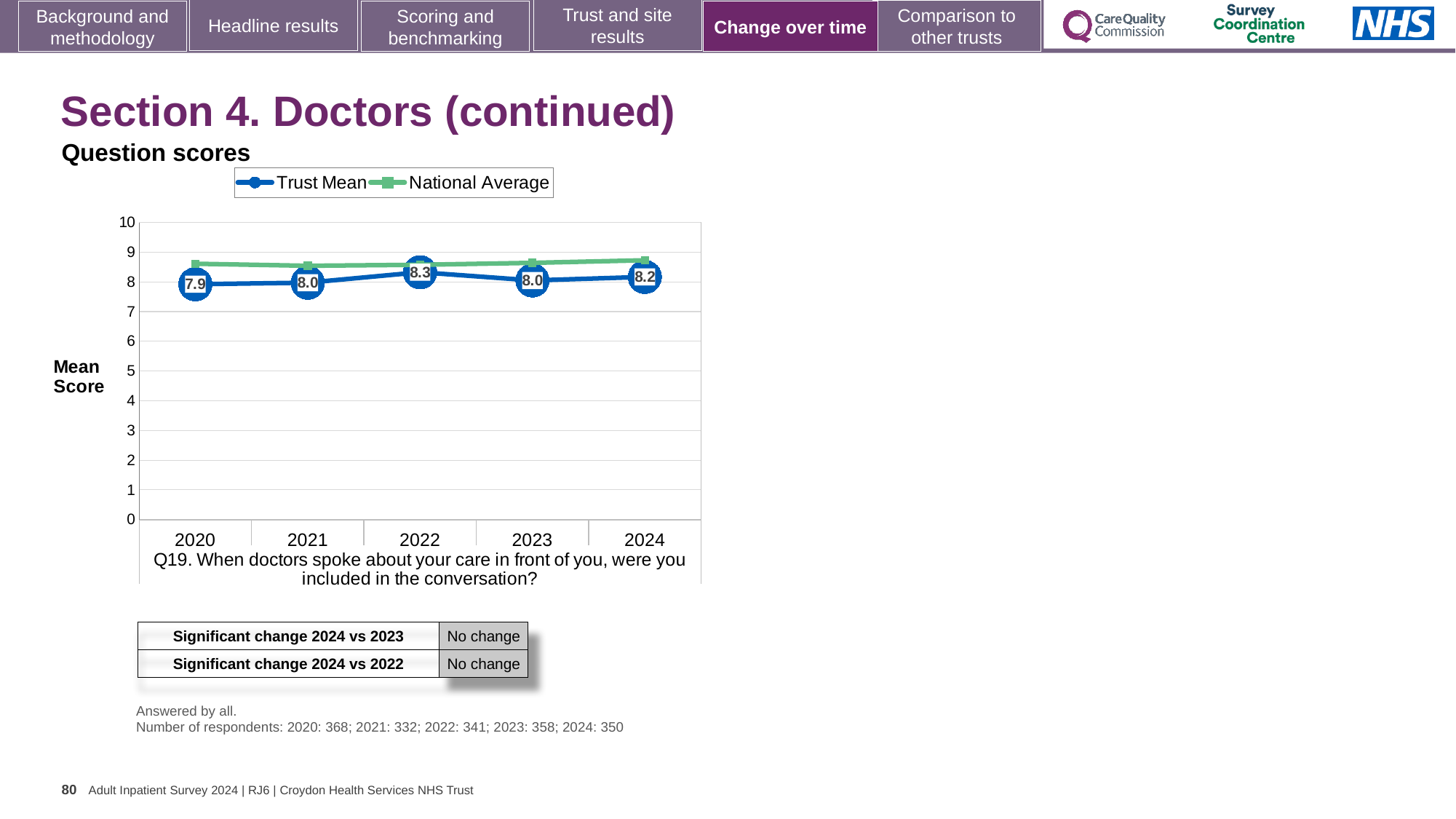
What is the difference between the Trust Mean in 2024 and in 2023? 0.2 What is the Trust Mean score for 2024? 8.2 What is the Trust Mean score for 2022? 8.3 What is the Trust Mean score for 2020? 7.9 How many years are shown on the x axis? 5 Does the Trust Mean rise or fall from 2023 to 2024? Rise Is the National Average value for 2024 greater or less than 8? greater In which year is the Trust Mean highest? 2022 Which is larger, the Trust Mean in 2022 or in 2021? 2022 How many series does the legend list? 2 What kind of chart is shown? Line chart In which year is the Trust Mean lowest? 2020